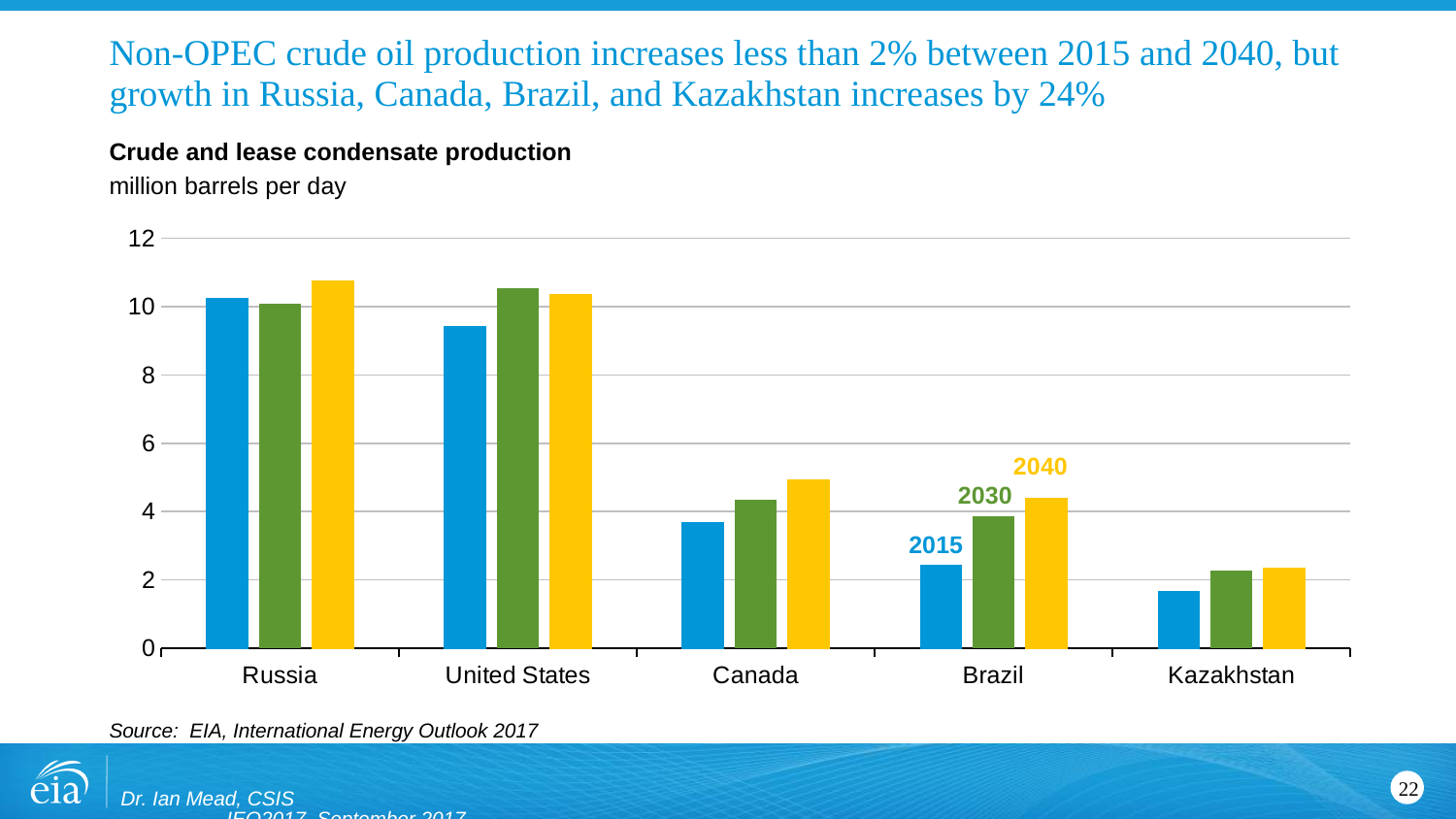
How many series (years) does the chart show for each country? 3 Is the 2015 value for Kazakhstan greater or less than 2? less Is the 2015 value for Brazil greater or less than 2? greater Is the 2040 value for Russia greater or less than 10? greater Which has the larger 2040 value, Canada or Brazil? Canada Which has the larger 2015 value, Russia or the United States? Russia Do Canada's values rise or fall from 2015 to 2030 to 2040? rise What kind of chart is shown on the slide? bar chart How many countries are shown on the x axis of the chart? 5 Which country has the lowest 2015 production value? Kazakhstan What unit is the chart's y axis measured in? million barrels per day